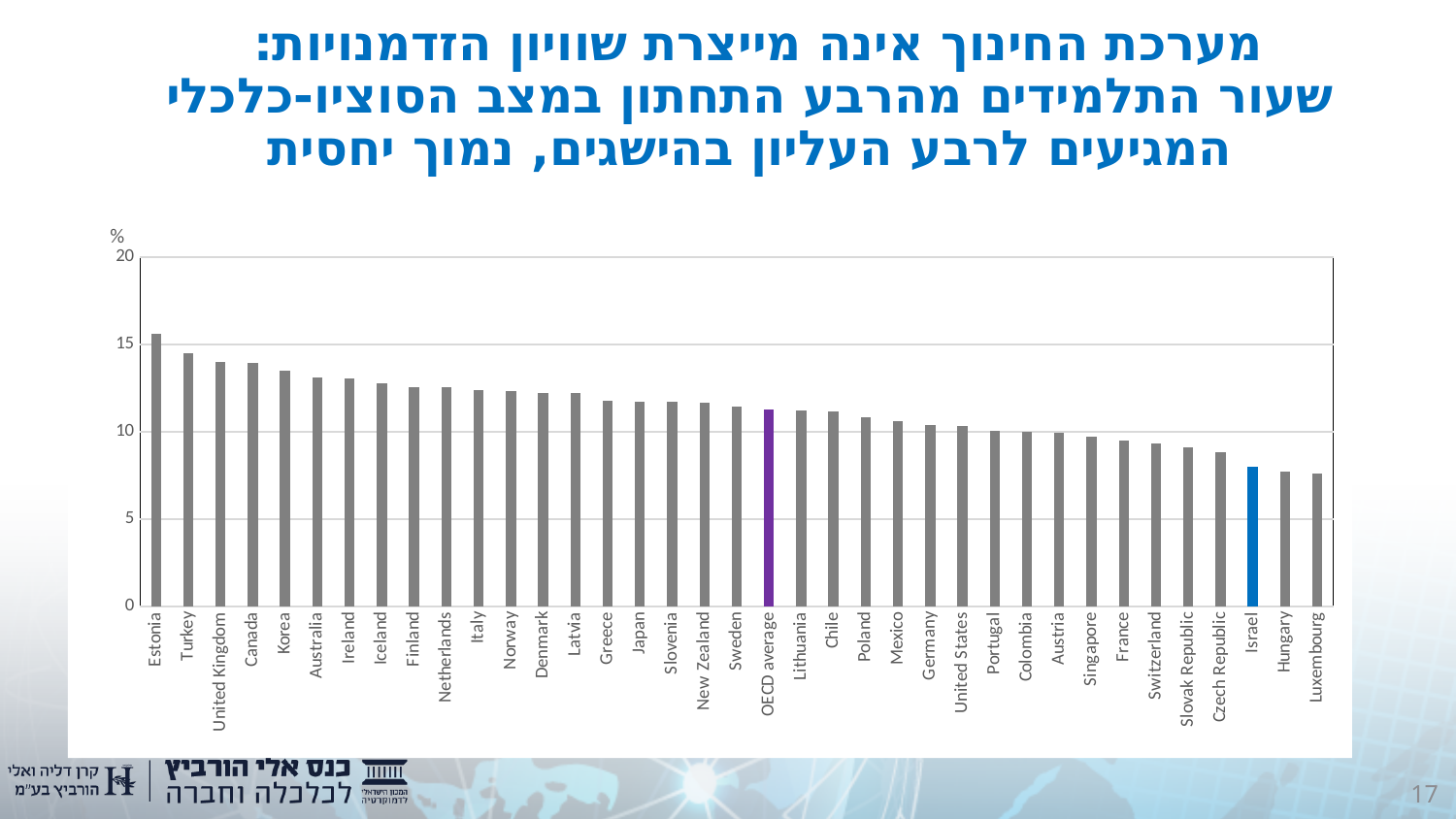
What colour is the bar for Israel? blue Is the value for Israel greater or less than 10? less Do the bar values rise or fall moving from left to right along the x axis? fall How many bars (categories) are plotted in the chart? 37 Is the value for the OECD average greater or less than 10? greater Which has a larger value, Estonia or Israel? Estonia Is the value for Luxembourg greater or less than 10? less What kind of chart is shown on the slide? bar chart Which country has the highest value in the chart? Estonia Which has a larger value, Korea or Germany? Korea